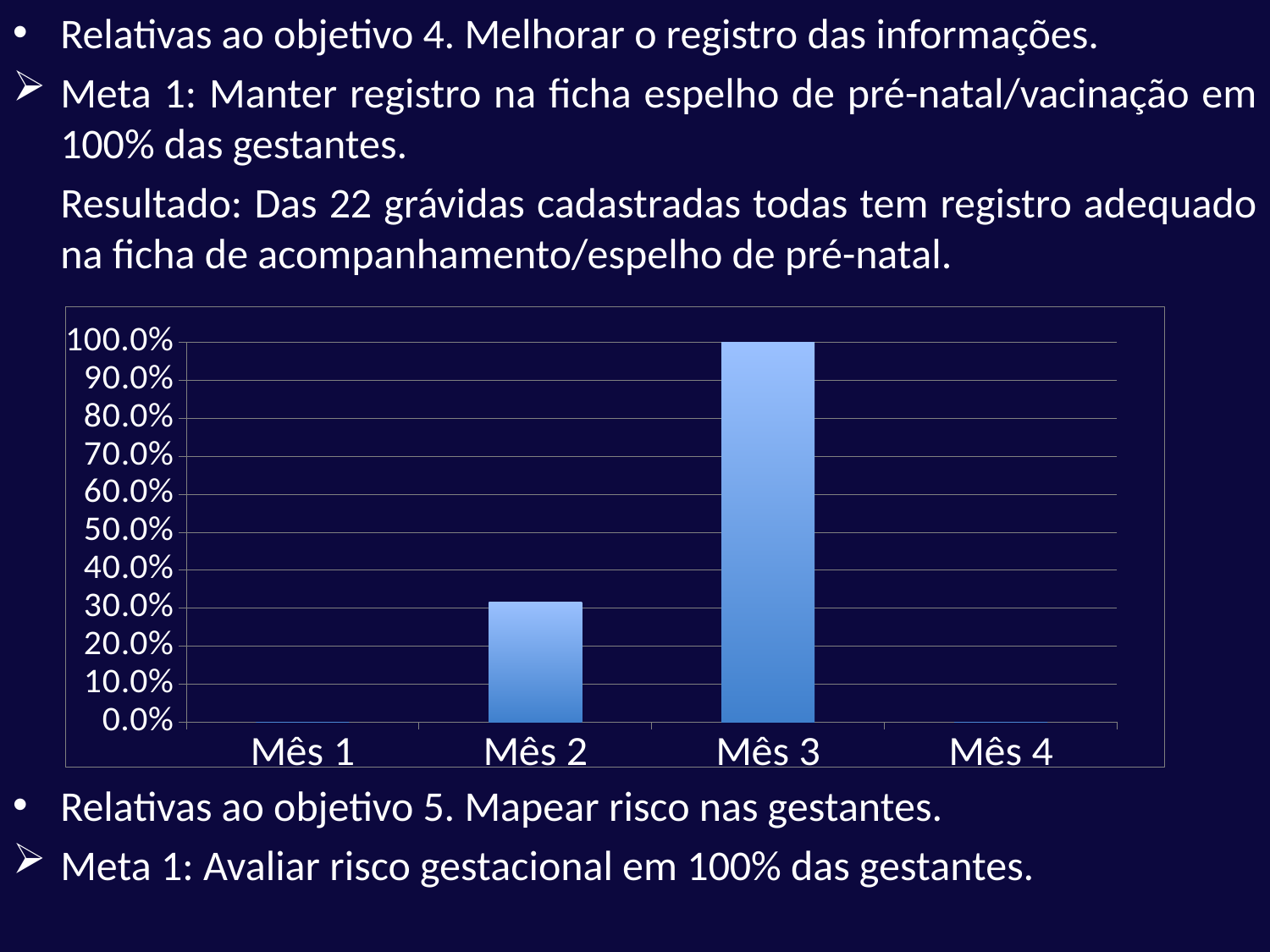
Is the value for Mês 2 greater or less than 20.0%? greater Is the value for Mês 2 greater or less than 50.0%? less What kind of chart is shown on the slide? bar chart How many categories are shown on the x axis of the chart? 4 What is the highest tick label on the y axis of the chart? 100.0% Does the value rise or fall from Mês 2 to Mês 3? rise Which month has the highest value in the chart? Mês 3 What is the value for Mês 3 in the chart? 100.0% How many months have a visible bar in the chart? 2 Which is larger, the value for Mês 2 or the value for Mês 3? Mês 3 What is the label of the first category on the x axis? Mês 1